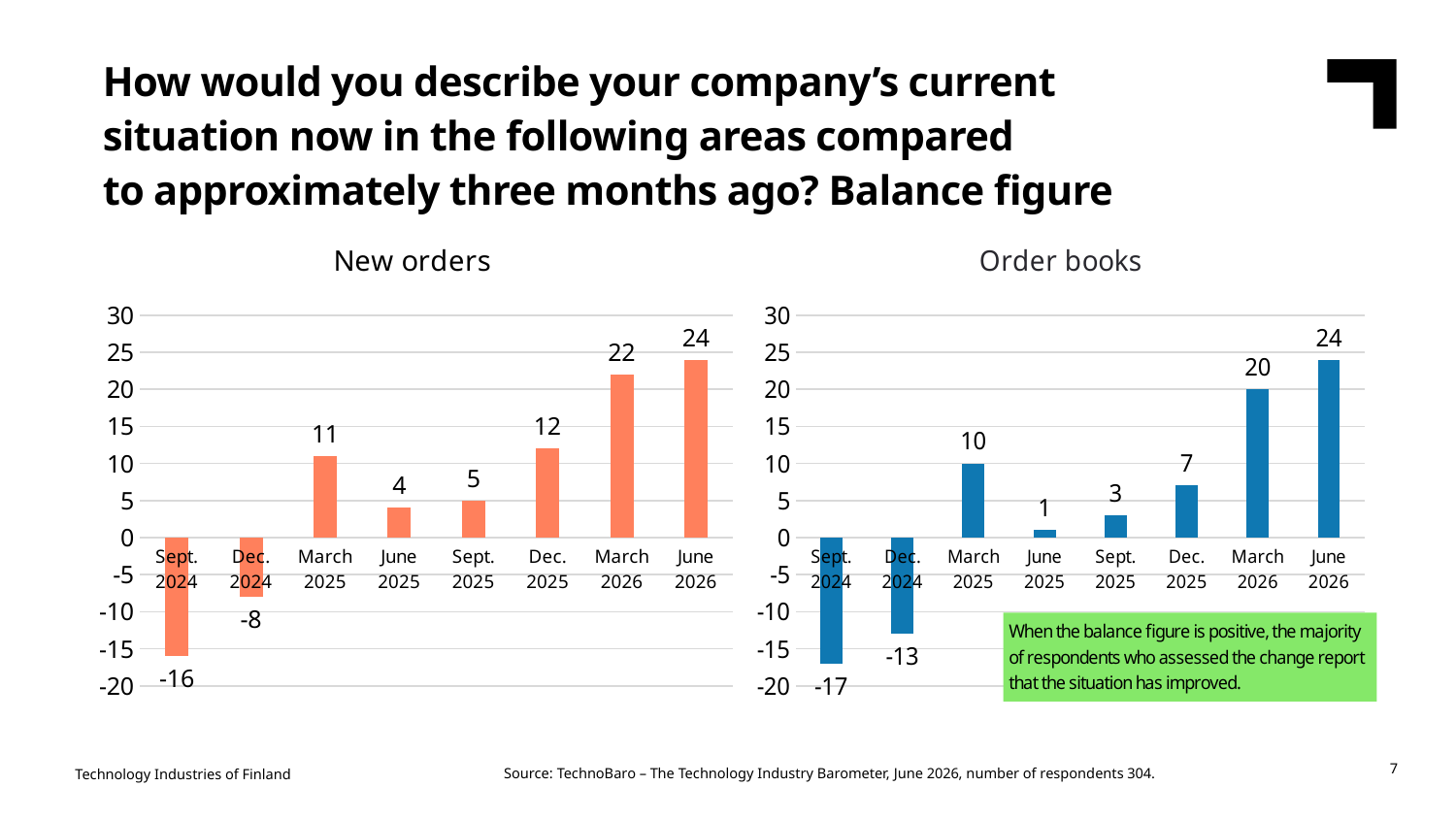
What kind of chart is the New orders chart? bar chart How many periods are shown on the x axis of the Order books chart? 8 In the Order books chart, which period has the highest value? June 2026 In the Order books chart, what is the difference between the values for March 2026 and March 2025? 10 In the New orders chart, is the value for Sept. 2024 greater or less than -10? less In the New orders chart, what is the value for March 2026? 22 In the Order books chart, which is larger, the value for Sept. 2025 or the value for Dec. 2025? Dec. 2025 In the Order books chart, do the values rise or fall from Dec. 2025 to June 2026? rise In the New orders chart, which period has the lowest value? Sept. 2024 What is the title of the chart on the right side of the slide? Order books In the New orders chart, what is the difference between the values for June 2026 and Dec. 2025? 12 In the Order books chart, what is the value for Dec. 2024? -13